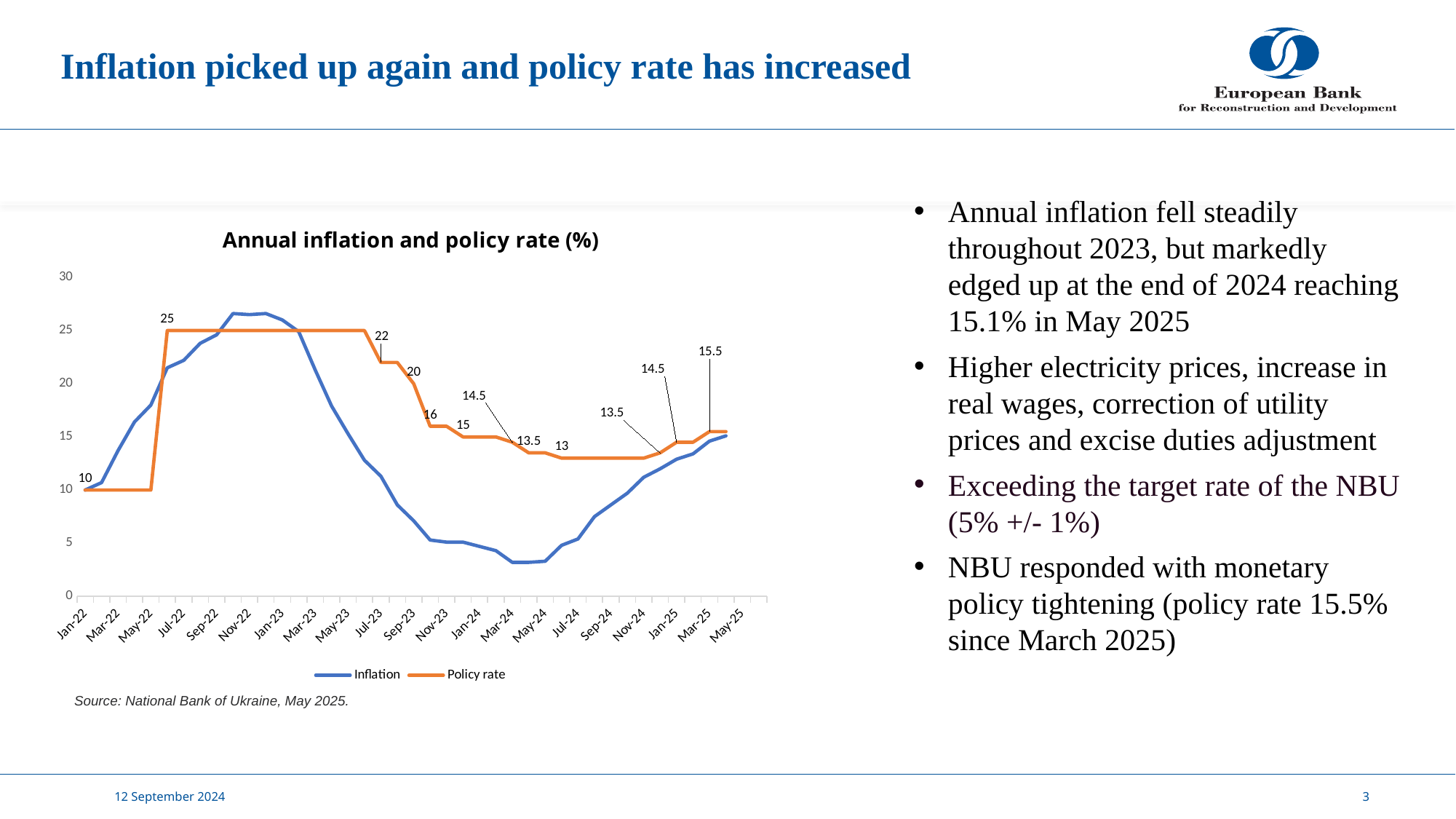
What is the highest labelled value of the policy rate series? 25 At Jul-23, which series has the higher value, Inflation or Policy rate? Policy rate Is the inflation value at Mar-24 greater or less than 5? less What is the policy rate value at May-25, the last point on the chart? 15.5 Is the inflation value at Nov-22 greater or less than 25? greater What is the policy rate value at Jan-22? 10 What kind of chart is shown on the slide? line chart How many series does the legend list? 2 What is the difference between the highest labelled policy rate (25) and the lowest labelled policy rate (13)? 12 What is the lowest labelled value of the policy rate series? 13 Does the inflation series rise or fall between Jan-23 and Mar-24? fall What is the title of the chart? Annual inflation and policy rate (%)